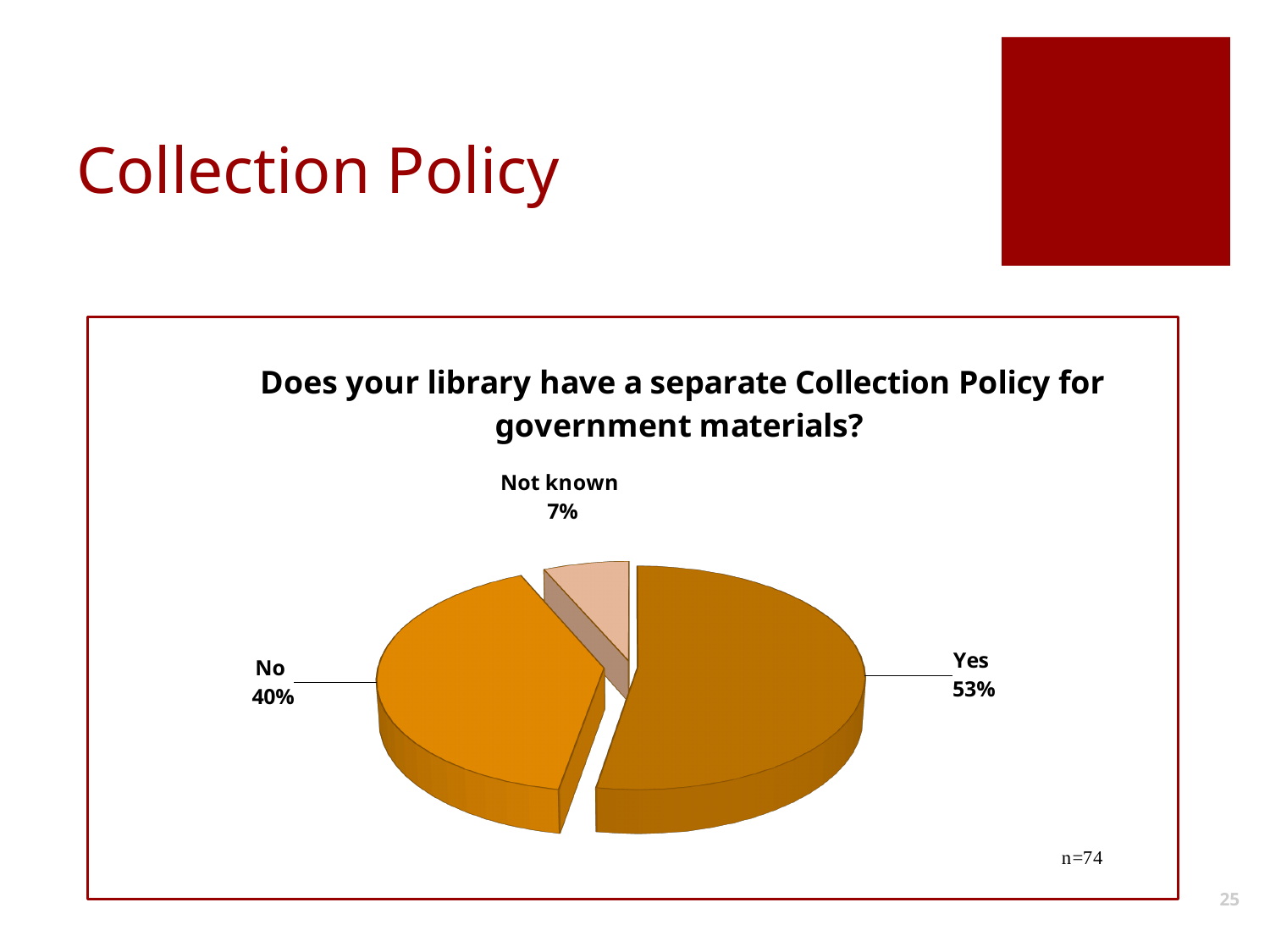
What sample size (n) is shown on the chart? n=74 What percentage of respondents answered "No"? 40% What type of chart is shown on the slide? pie chart Which response has the largest share of the pie? Yes What is the difference in percentage points between the "No" and "Not known" slices? 33 What percentage of respondents answered "Not known"? 7% Which slice is larger, "No" or "Not known"? No Which response has the smallest share of the pie? Not known What is the title of the chart? Does your library have a separate Collection Policy for government materials? What percentage of respondents answered "Yes"? 53% How many slices does the pie chart have? 3 What is the difference in percentage points between the "Yes" and "No" slices? 13